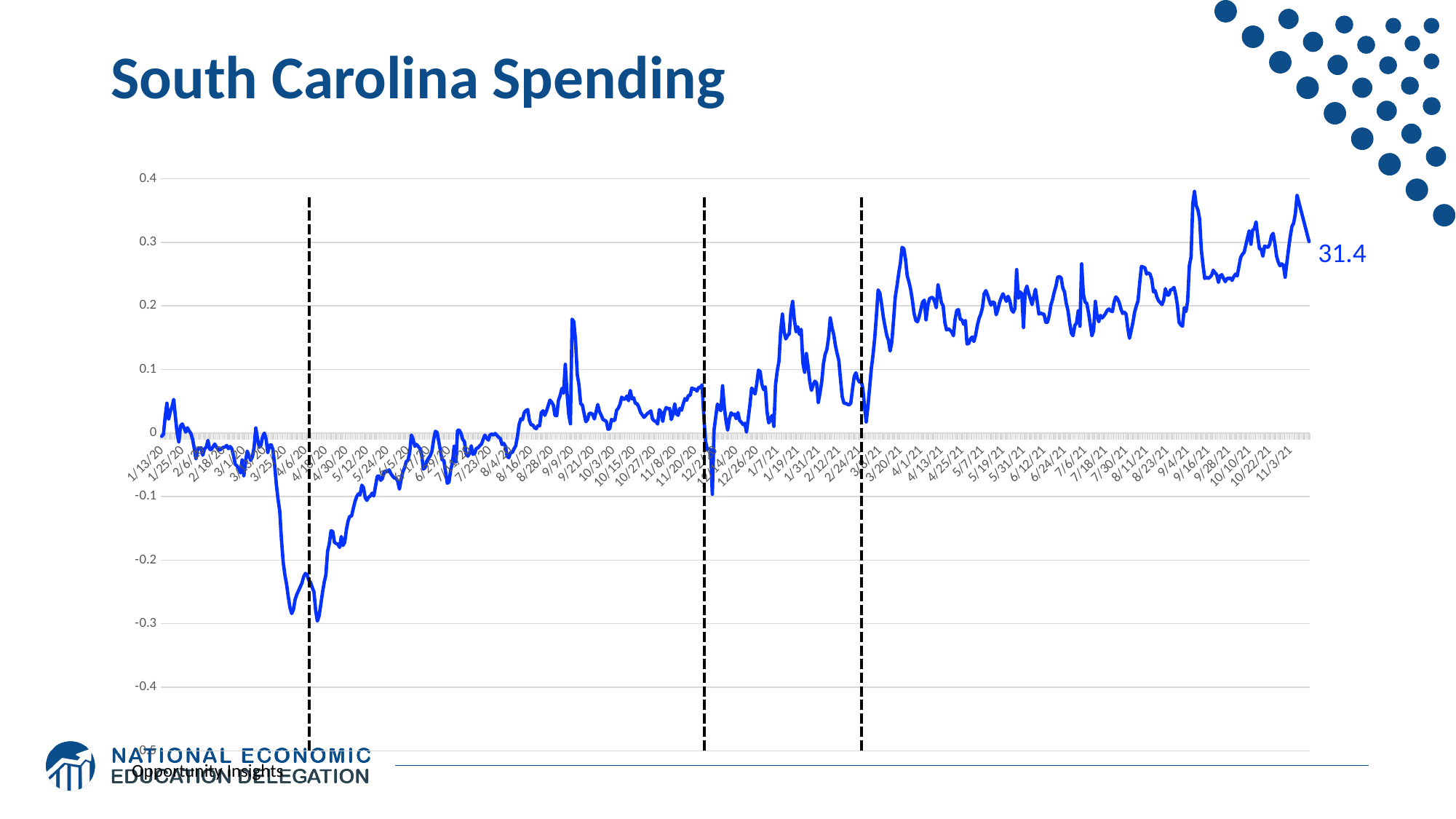
Which is larger, the value at 1/13/20 or the value at 11/3/21? 11/3/21 What value is printed as the data label at the end of the line? 31.4 Is the value around 3/20/21 greater or less than 0.1? greater Is the value at the end of the line (11/3/21) greater or less than 0.2? greater What kind of chart is shown on the slide? line chart What is the title of the chart? South Carolina Spending Is the value at 1/13/20 greater or less than 0.1? less Which is larger, the value around 4/18/20 or the value around 9/4/21? 9/4/21 How many dashed vertical lines are drawn on the chart? 3 Overall, does the line rise or fall from the start of the x axis (1/13/20) to the end (11/3/21)? rise In which month does the line reach its lowest point? April 2020